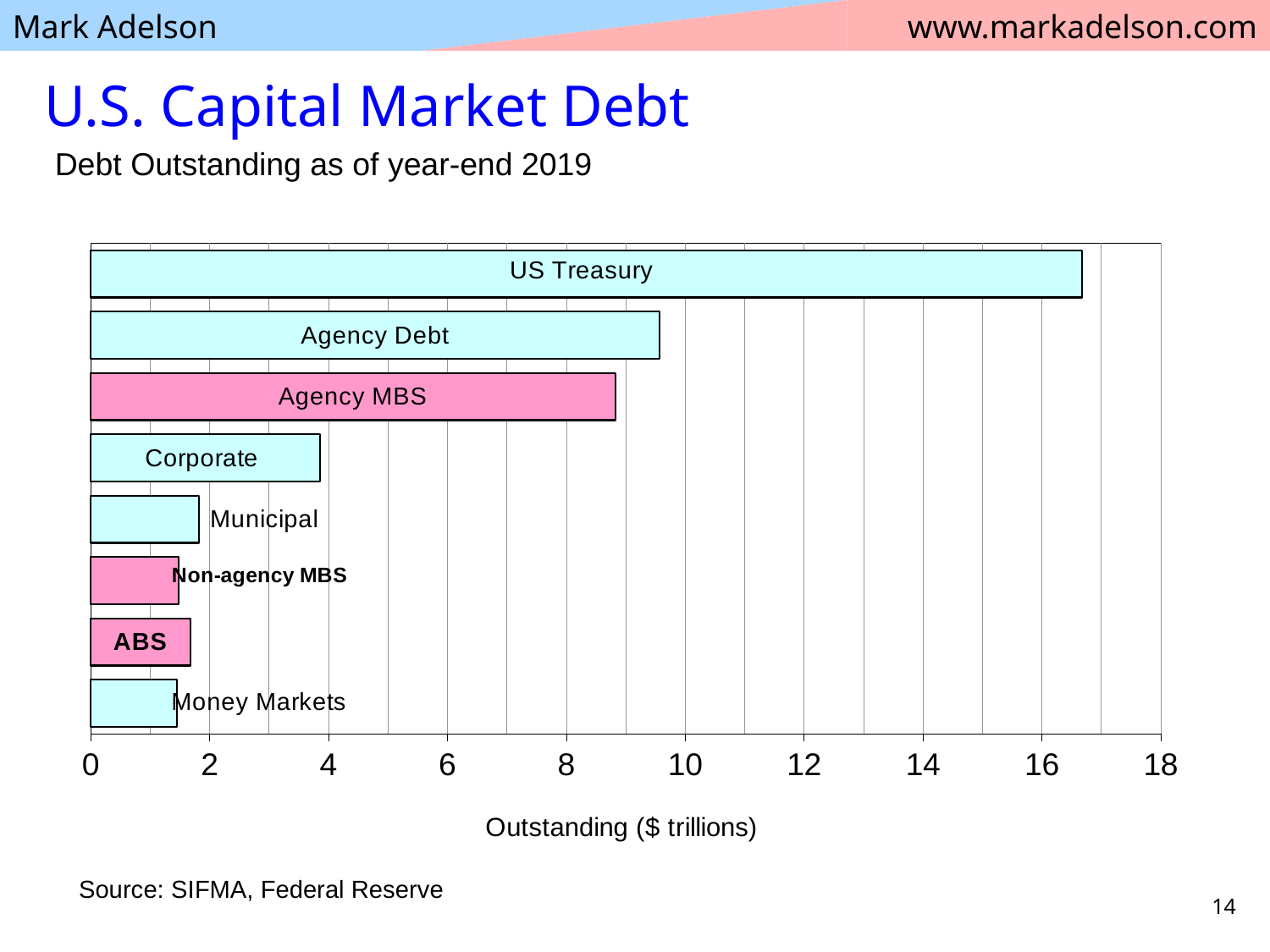
What kind of chart is shown on the slide? Bar chart How many debt categories are plotted in the chart? 8 Is the value for Money Markets greater or less than 2? less Which three categories are shown with pink bars? Agency MBS, Non-agency MBS, ABS Is the value for US Treasury greater or less than 16? greater Which is larger, Corporate or Municipal? Corporate Is the value for Agency Debt greater or less than 10? less What is the title of the horizontal axis? Outstanding ($ trillions) Which category has the largest amount of debt outstanding? US Treasury Which is larger, Agency Debt or Agency MBS? Agency Debt